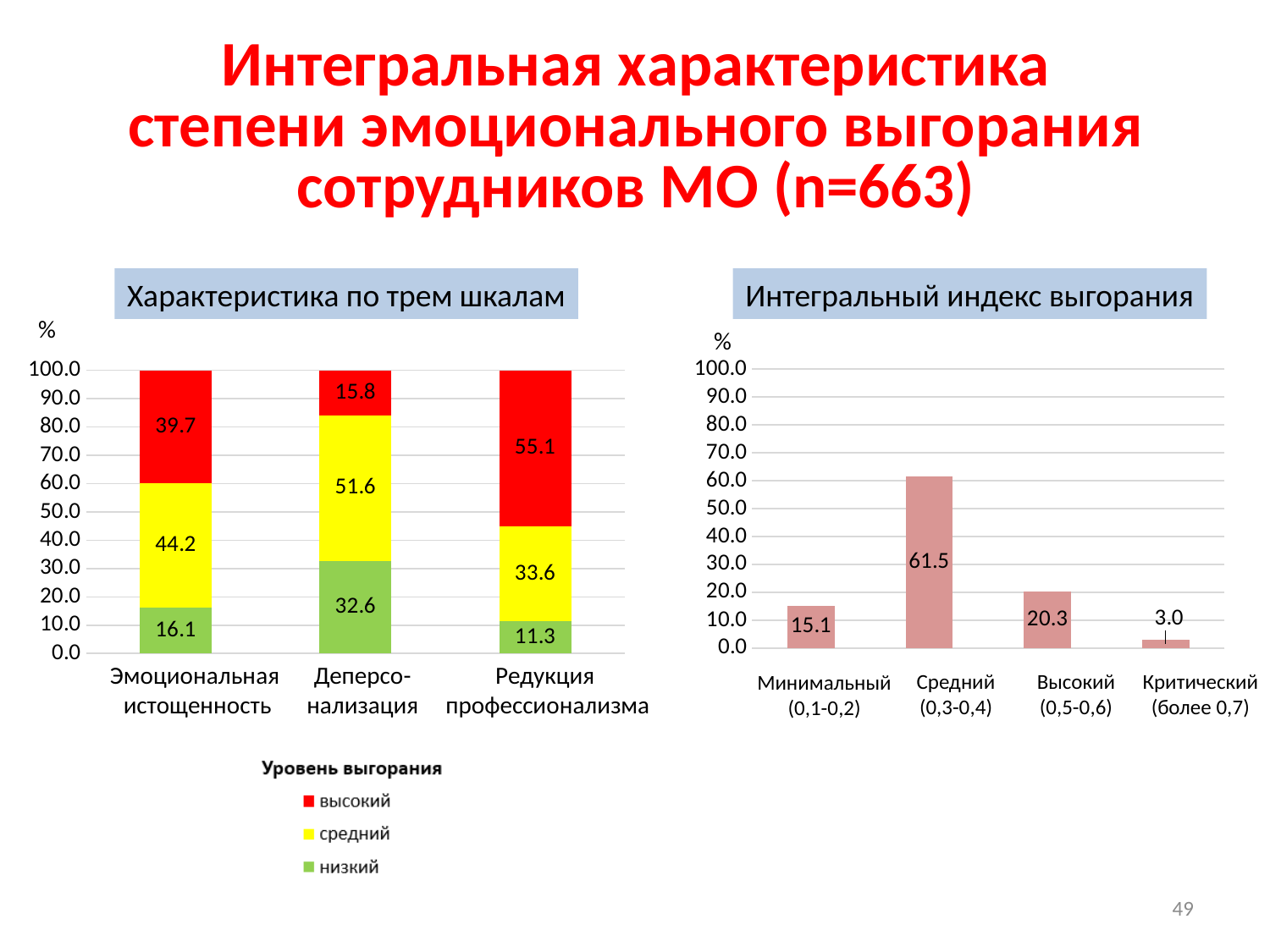
In the chart 'Интегральный индекс выгорания', what is the difference between the values for 'Высокий (0,5-0,6)' and 'Минимальный (0,1-0,2)'? 5.2 In the chart 'Интегральный индекс выгорания', which category has the lowest value? Критический (более 0,7) In the chart 'Характеристика по трем шкалам', which category has the highest 'высокий' value? Редукция профессионализма In the chart 'Характеристика по трем шкалам', what is the value of the 'средний' level for 'Редукция профессионализма'? 33.6 In the chart 'Интегральный индекс выгорания', how many categories are shown? 4 In the chart 'Характеристика по трем шкалам', what is the value of the 'низкий' level for 'Деперсонализация'? 32.6 What kind of chart is 'Интегральный индекс выгорания'? Bar chart In the chart 'Характеристика по трем шкалам', how many series does the legend list? 3 In the chart 'Характеристика по трем шкалам', what is the difference between the 'средний' values for 'Деперсонализация' and 'Эмоциональная истощенность'? 7.4 In the chart 'Интегральный индекс выгорания', what is the value for 'Средний (0,3-0,4)'? 61.5 In the chart 'Характеристика по трем шкалам', which colour represents the 'высокий' level? Red In the chart 'Характеристика по трем шкалам', what is the value of the 'высокий' level for 'Эмоциональная истощенность'? 39.7